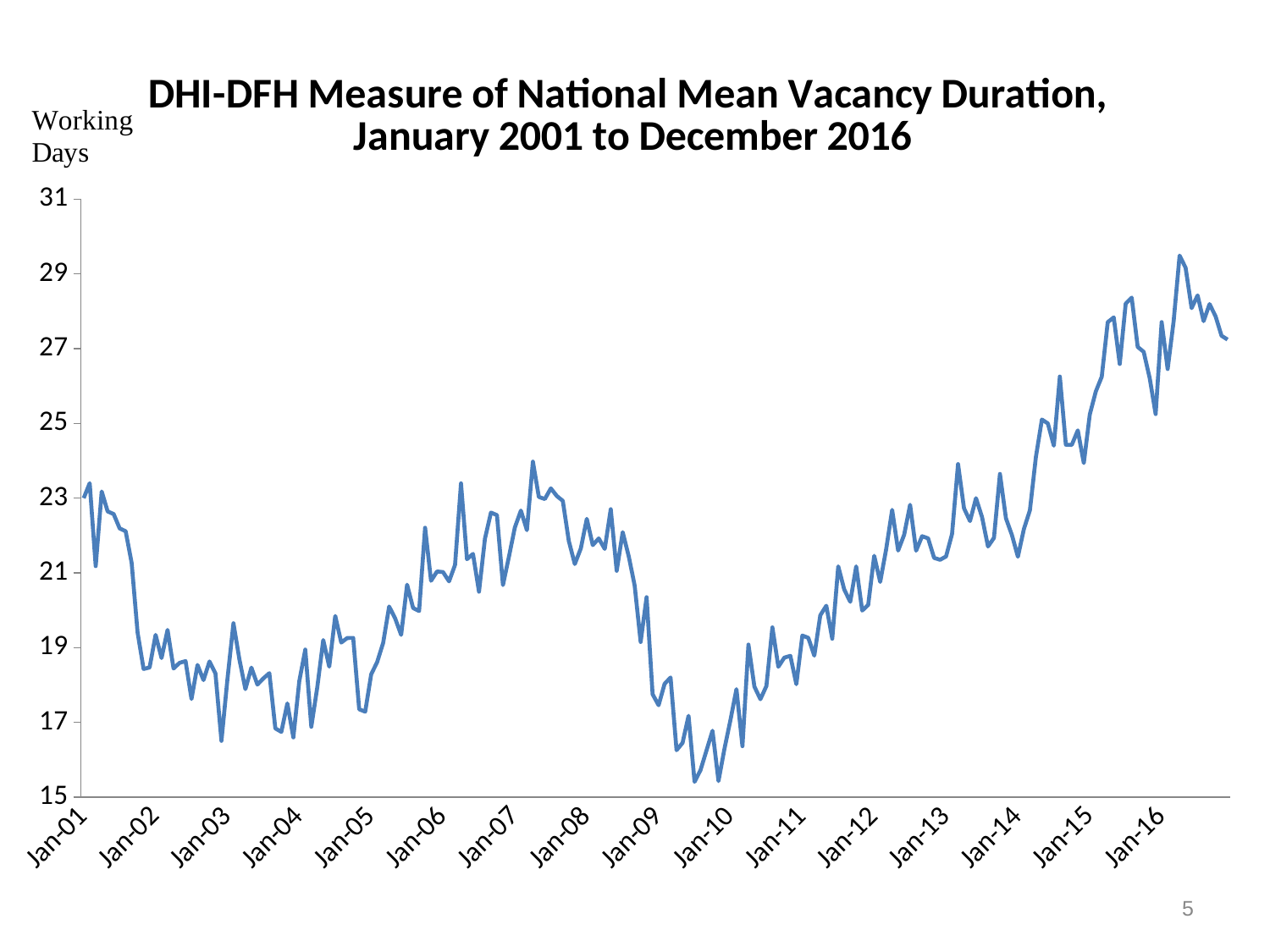
Is the value at Jan-16 greater or less than 25? greater What unit is the vertical axis labelled with? Working Days What is the title of the chart? DHI-DFH Measure of National Mean Vacancy Duration, January 2001 to December 2016 Does the line rise or fall between Jan-10 and Jan-16? rise In which year does the line reach its highest point? 2016 Is the value at Jan-03 greater or less than 21? less How many year labels are shown along the x axis? 16 How many series are plotted on the chart? 1 What kind of chart is shown on the slide? line chart Is the value at Jan-07 greater or less than 21? greater